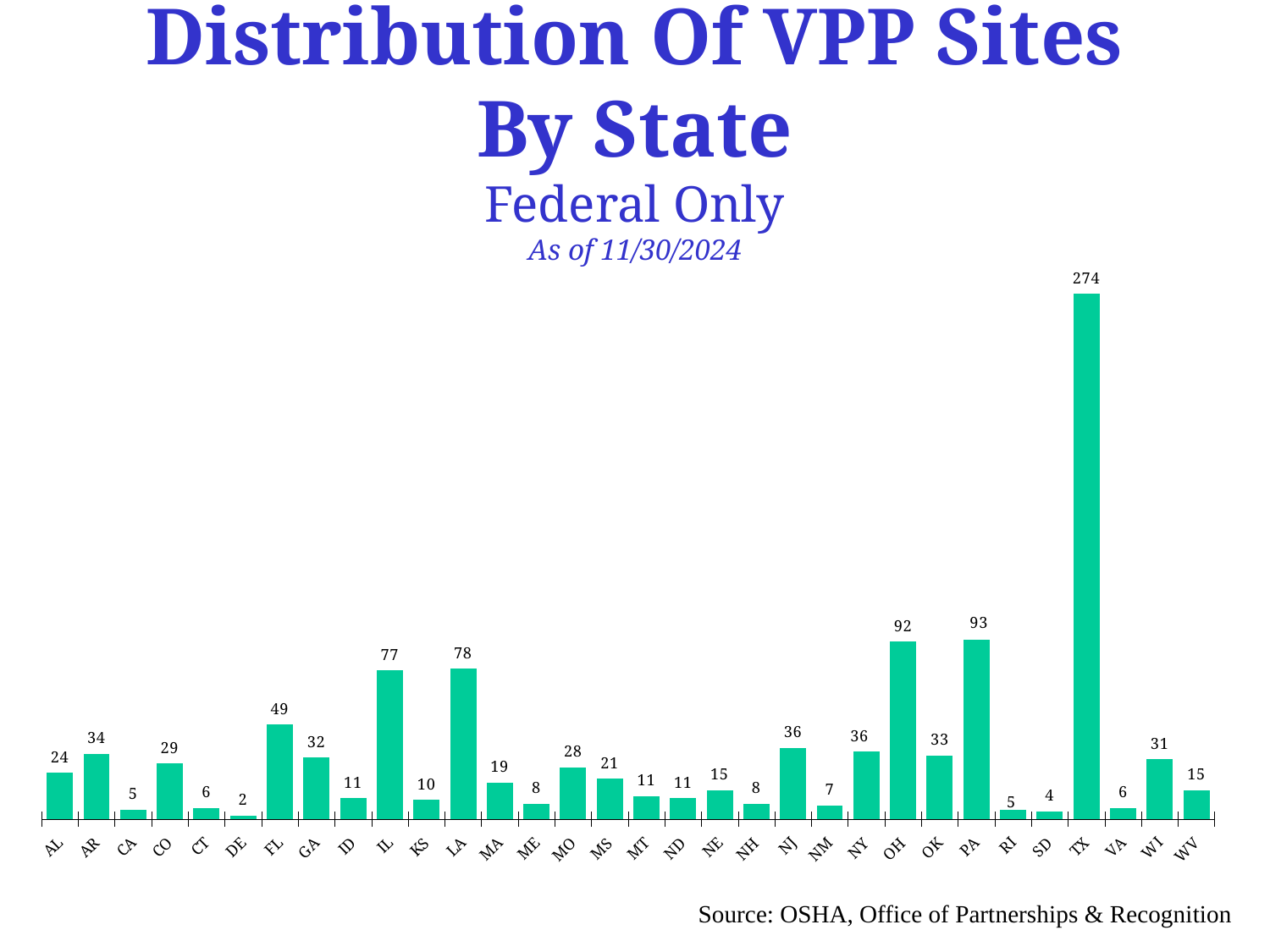
What is the difference between the number of VPP sites in FL and GA? 17 Which state has the highest number of VPP sites? TX What is the 'as of' date shown under the chart title? 11/30/2024 Which has more VPP sites, IL or NJ? IL What is the number of VPP sites for TX? 274 How many states are shown on the chart? 32 Which has more VPP sites, AR or CO? AR What is the number of VPP sites for OH? 92 What is the difference between the number of VPP sites in TX and PA? 181 What is the number of VPP sites for LA? 78 What kind of chart is shown on the slide? Bar chart Which state has the lowest number of VPP sites? DE